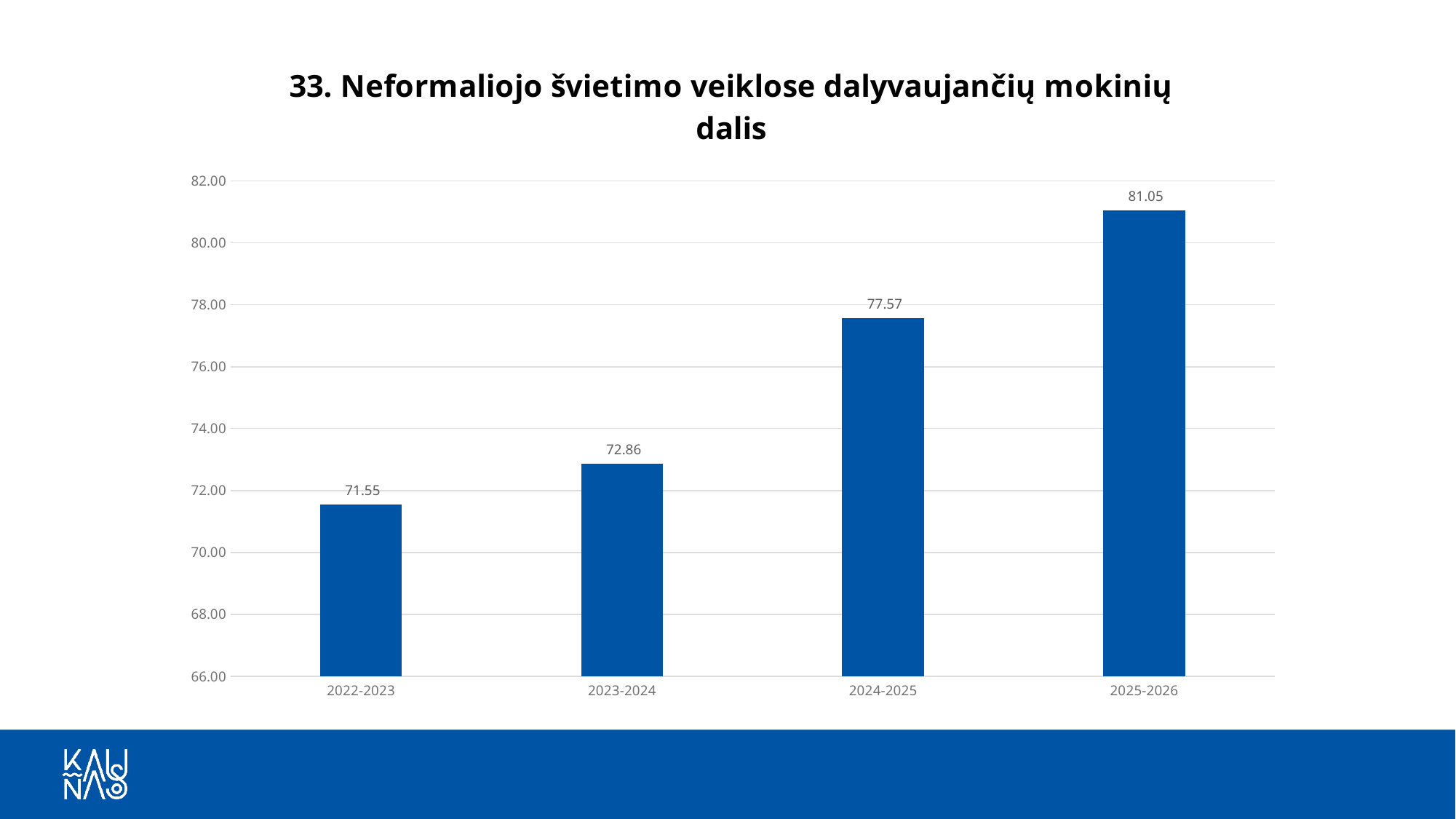
What is the value for 2023-2024? 72.86 What is the difference between the values for 2024-2025 and 2023-2024? 4.71 Which category has the lowest value? 2022-2023 Which is larger, the value for 2023-2024 or the value for 2024-2025? 2024-2025 What is the value for 2025-2026? 81.05 Which category has the highest value? 2025-2026 What is the value for 2024-2025? 77.57 What is the value for 2022-2023? 71.55 What kind of chart is shown on the slide? bar chart Is the value for 2025-2026 greater or less than 80.00? greater How many categories are shown on the x axis? 4 What is the difference between the values for 2025-2026 and 2022-2023? 9.50